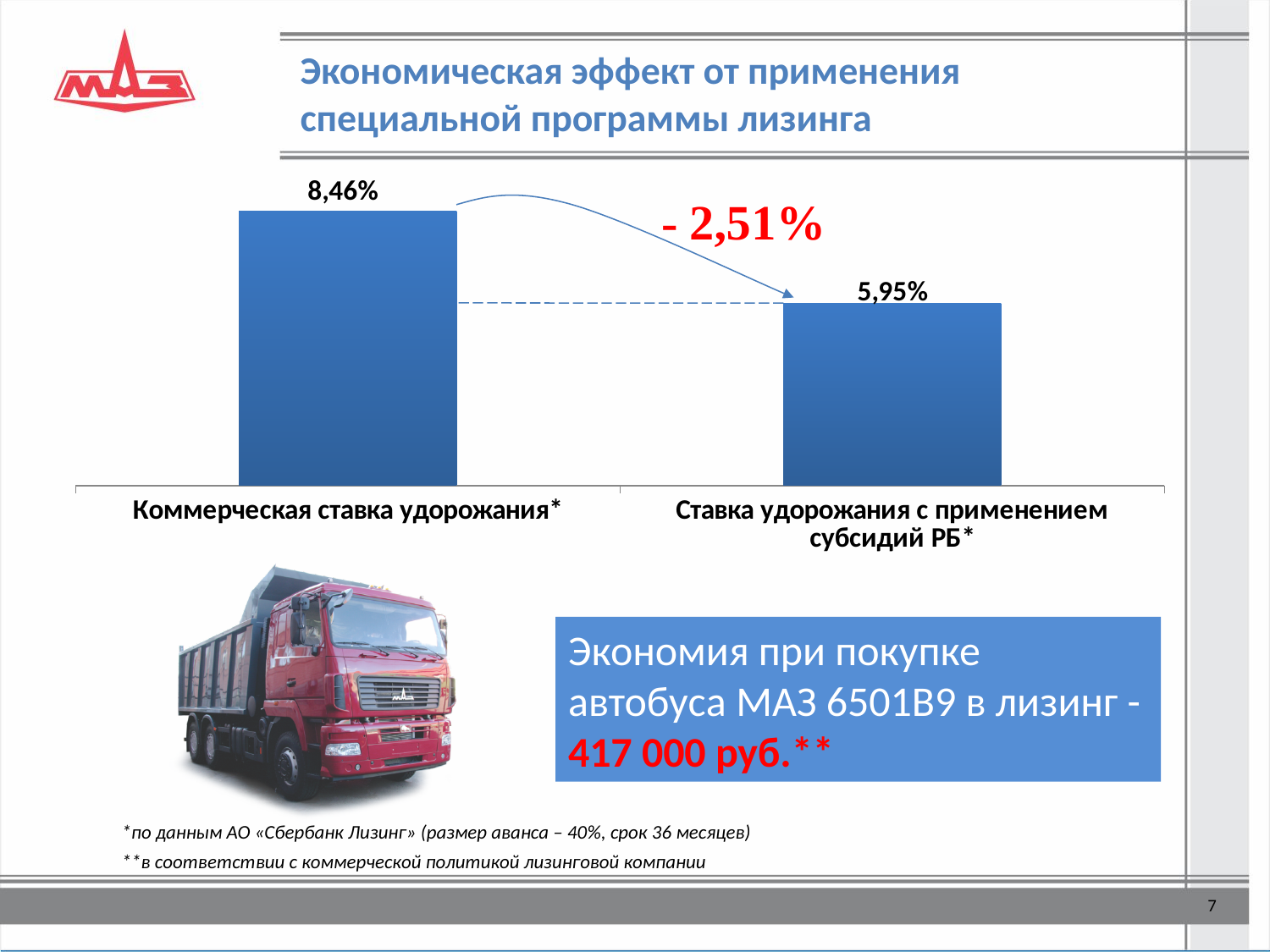
Which is larger: «Коммерческая ставка удорожания*» or «Ставка удорожания с применением субсидий РБ*»? Коммерческая ставка удорожания* Which category has the lowest value? Ставка удорожания с применением субсидий РБ* What reduction is printed in red next to the arrow between the two bars? - 2,51% What colour are the bars in the chart? Blue What is the value for «Ставка удорожания с применением субсидий РБ*»? 5,95% How many bars are shown in the chart? 2 What is the value for «Коммерческая ставка удорожания*»? 8,46% What is the difference between «Коммерческая ставка удорожания*» and «Ставка удорожания с применением субсидий РБ*»? 2,51% Which category has the highest value? Коммерческая ставка удорожания* What kind of chart is shown on the slide? Bar chart Do the values rise or fall from the left bar to the right bar? Fall